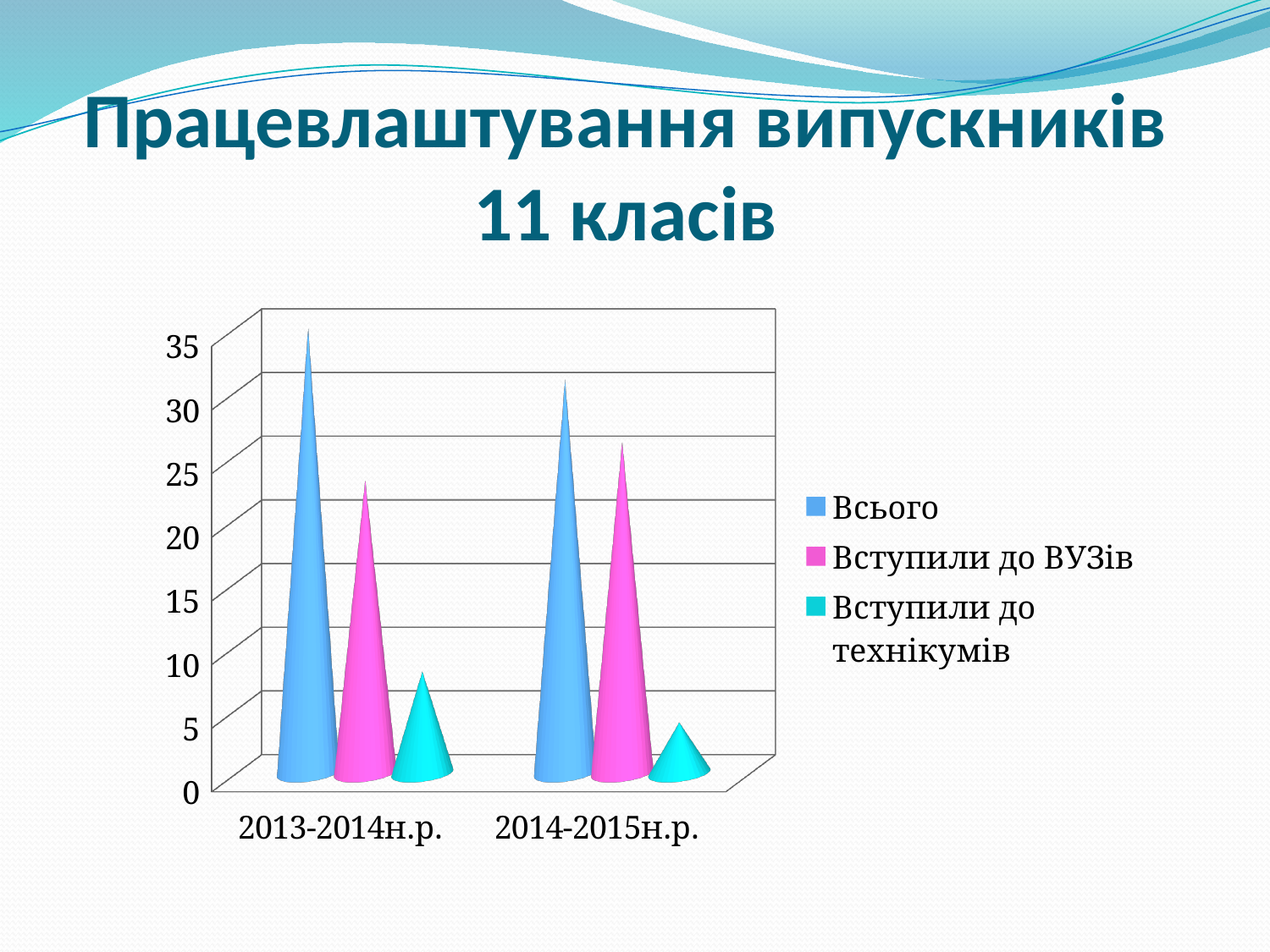
What kind of chart is shown on the slide? bar chart Is the value for Всього in 2014-2015н.р. greater or less than 25? greater Is the value for Вступили до технікумів in 2014-2015н.р. greater or less than 10? less How many categories are shown on the x axis? 2 Is the value for Вступили до ВУЗів in 2013-2014н.р. greater or less than 30? less How many series does the legend list? 3 Does the value for Всього rise or fall from 2013-2014н.р. to 2014-2015н.р.? fall Which year has the larger value for Вступили до ВУЗів, 2013-2014н.р. or 2014-2015н.р.? 2014-2015н.р. Which series has the lowest value in 2014-2015н.р.? Вступили до технікумів Which series has the highest value in 2013-2014н.р.? Всього What is the title of the slide? Працевлаштування випускників 11 класів